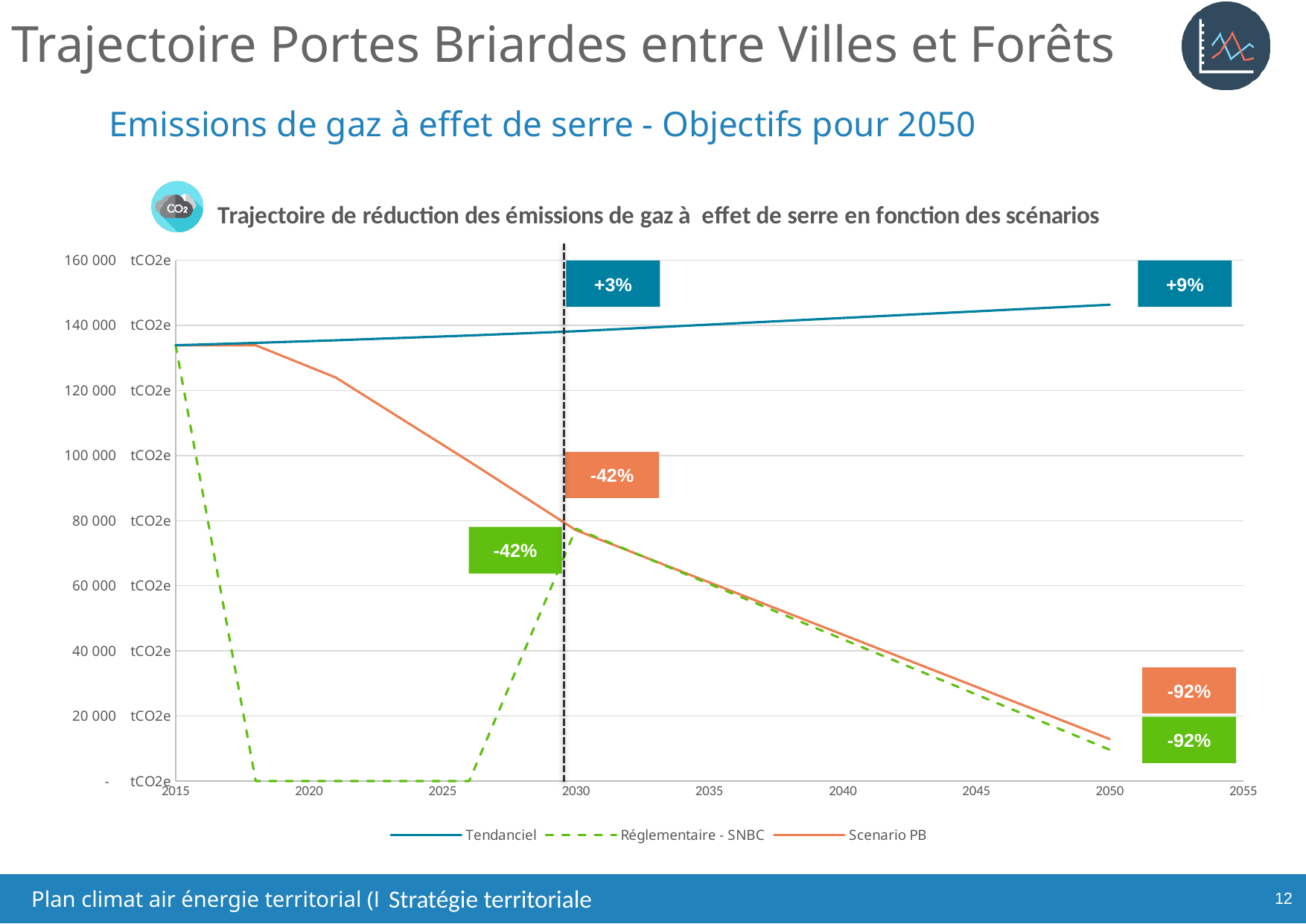
What percentage change is labelled for the Scenario PB series in 2050? -92% Does the Scenario PB series rise or fall between 2020 and 2050? fall What percentage change is labelled for the Tendanciel series in 2050? +9% What percentage change is labelled for the Scenario PB series at 2030? -42% Does the Tendanciel series rise or fall between 2015 and 2050? rise What are the three series listed in the legend? Tendanciel, Réglementaire - SNBC, Scenario PB What kind of chart is shown on the slide? line chart What percentage change is labelled for the Tendanciel series at 2030? +3% Which series has the lowest value in 2025? Réglementaire - SNBC How many series does the legend list? 3 Is the value of the Tendanciel series in 2050 greater or less than 140 000 tCO2e? greater Is the value of the Scenario PB series in 2050 greater or less than 20 000 tCO2e? less